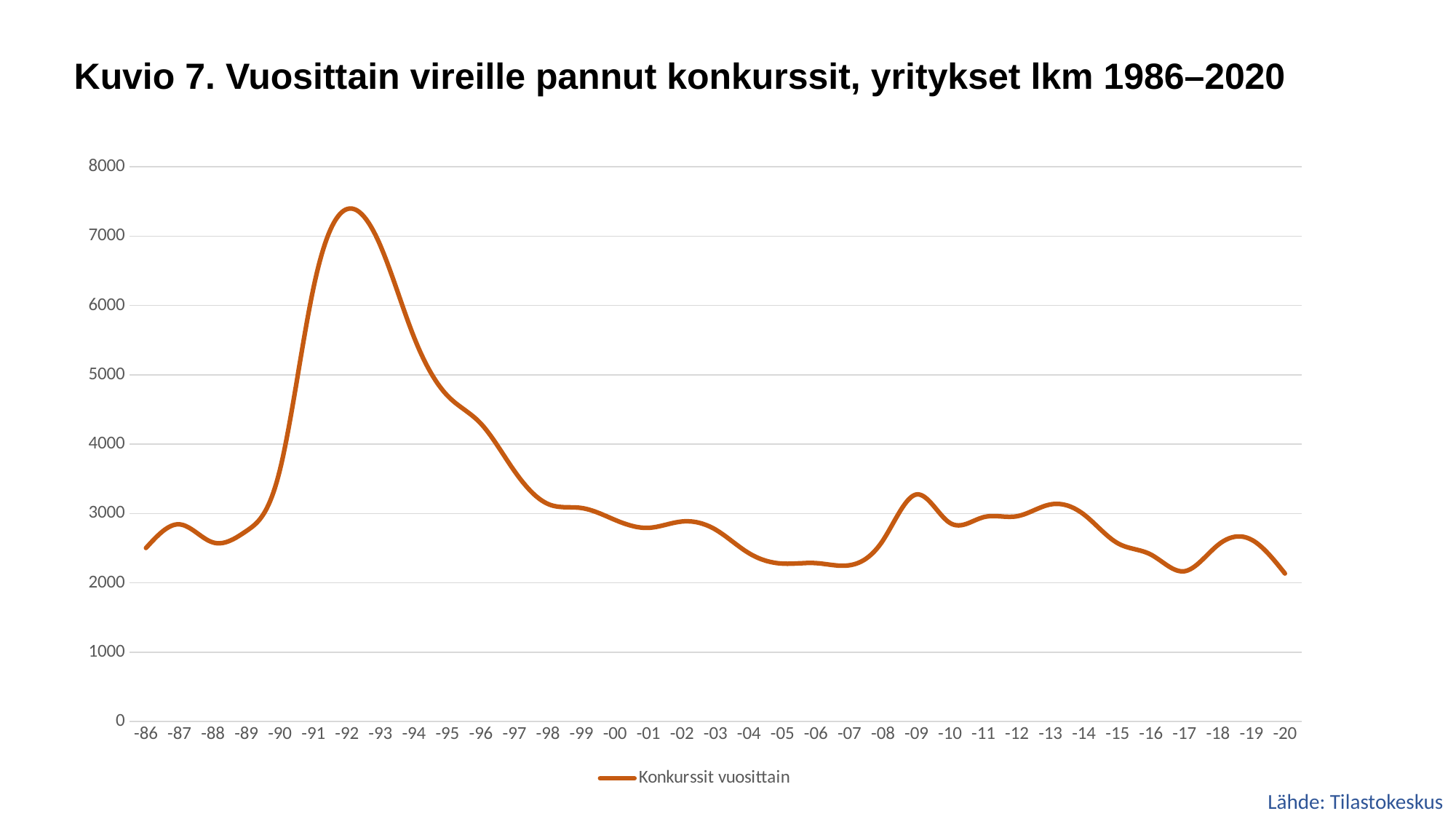
Is the value for -17 greater or less than 2500? less Is the value for -92 greater or less than 7000? greater Is the value for -05 greater or less than 3000? less Do the values rise or fall from -92 to -98? fall How many years (data points) are plotted along the x axis? 35 What kind of chart is shown on the slide? line chart How many series does the legend list? 1 What is the name of the series shown in the legend? Konkurssit vuosittain In which year does the line reach its highest value? -92 Which year has the larger value, -92 or -09? -92